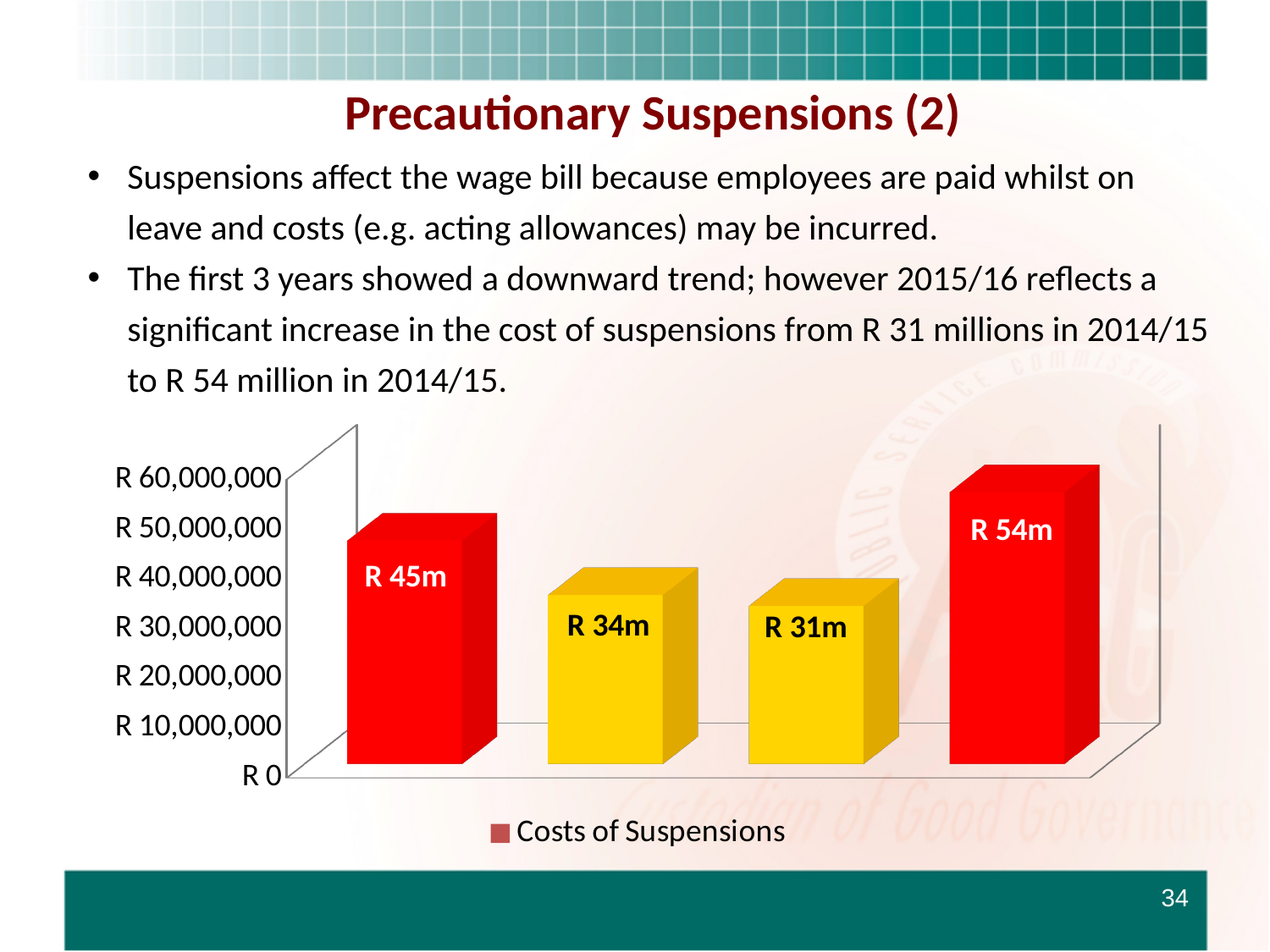
Which bar has the highest value? the fourth (rightmost) bar, R 54m How many bars are plotted in the chart? 4 Which is larger, the value of the first bar or the value of the second bar? the first bar (R 45m) Which bar has the lowest value? the third bar, R 31m What value is labelled on the first (leftmost) bar? R 45m How many series does the chart legend list? 1 What is the series name shown in the chart legend? Costs of Suspensions What type of chart is shown on the slide? bar chart Do the values fall or rise across the first three bars from left to right? fall What value is labelled on the third bar from the left? R 31m What value is labelled on the last (rightmost) bar? R 54m What is the difference between the value of the rightmost bar and the value of the third bar? R 23m